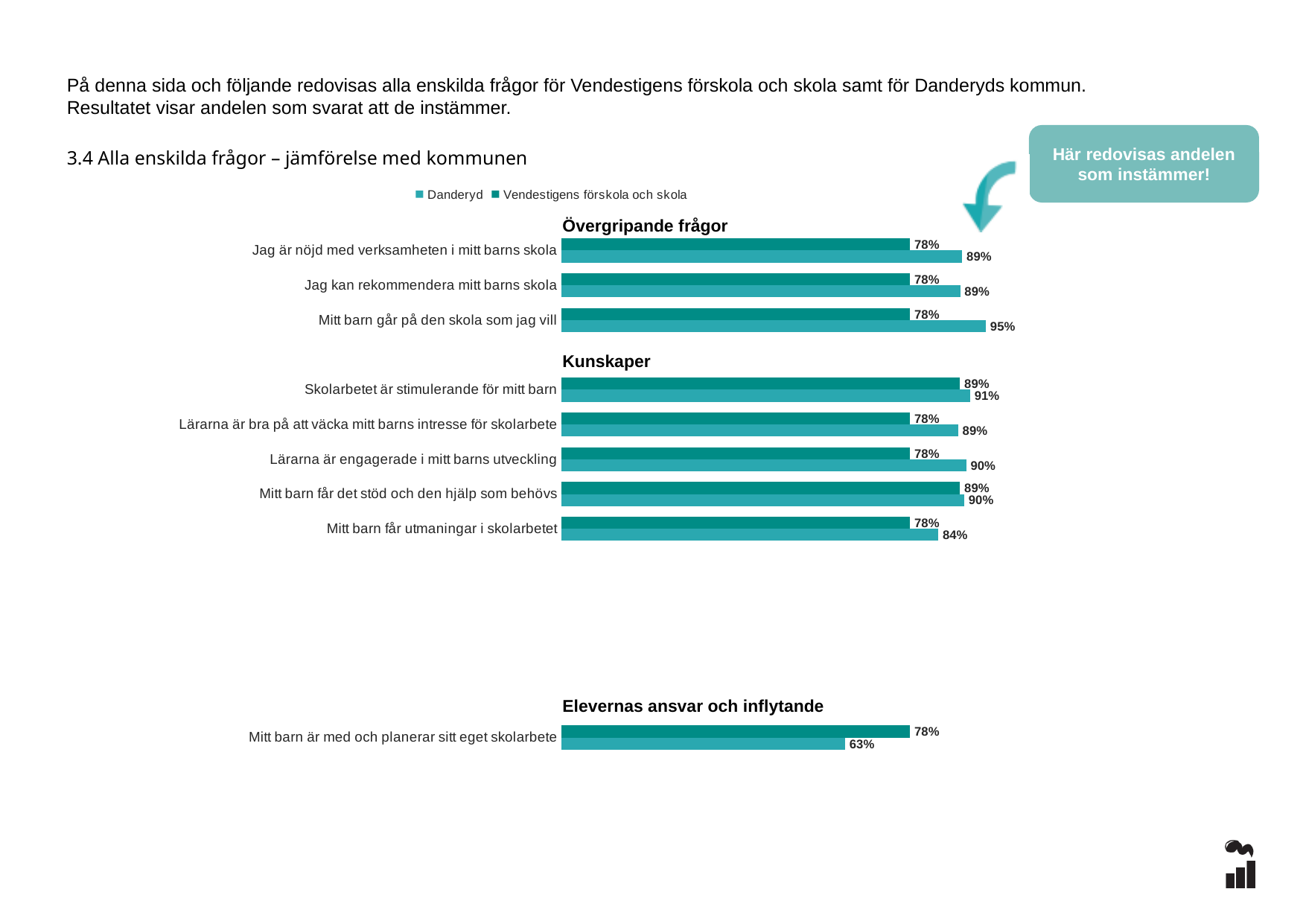
What is the Danderyd value for "Mitt barn är med och planerar sitt eget skolarbete"? 63% Which question has the lowest Danderyd value? Mitt barn är med och planerar sitt eget skolarbete How many questions are shown under the "Kunskaper" heading? 5 What is the difference between the Danderyd and Vendestigens förskola och skola values for "Mitt barn går på den skola som jag vill"? 17 percentage points What is the Danderyd value for "Skolarbetet är stimulerande för mitt barn"? 91% What is the Danderyd value for "Mitt barn går på den skola som jag vill"? 95% What is the Vendestigens förskola och skola value for "Mitt barn är med och planerar sitt eget skolarbete"? 78% What kind of chart is shown on the slide? Bar chart How many series does the chart legend list? 2 For "Mitt barn är med och planerar sitt eget skolarbete", which series has the higher value? Vendestigens förskola och skola Which two series are listed in the chart legend? Danderyd and Vendestigens förskola och skola Which question has the highest Danderyd value? Mitt barn går på den skola som jag vill